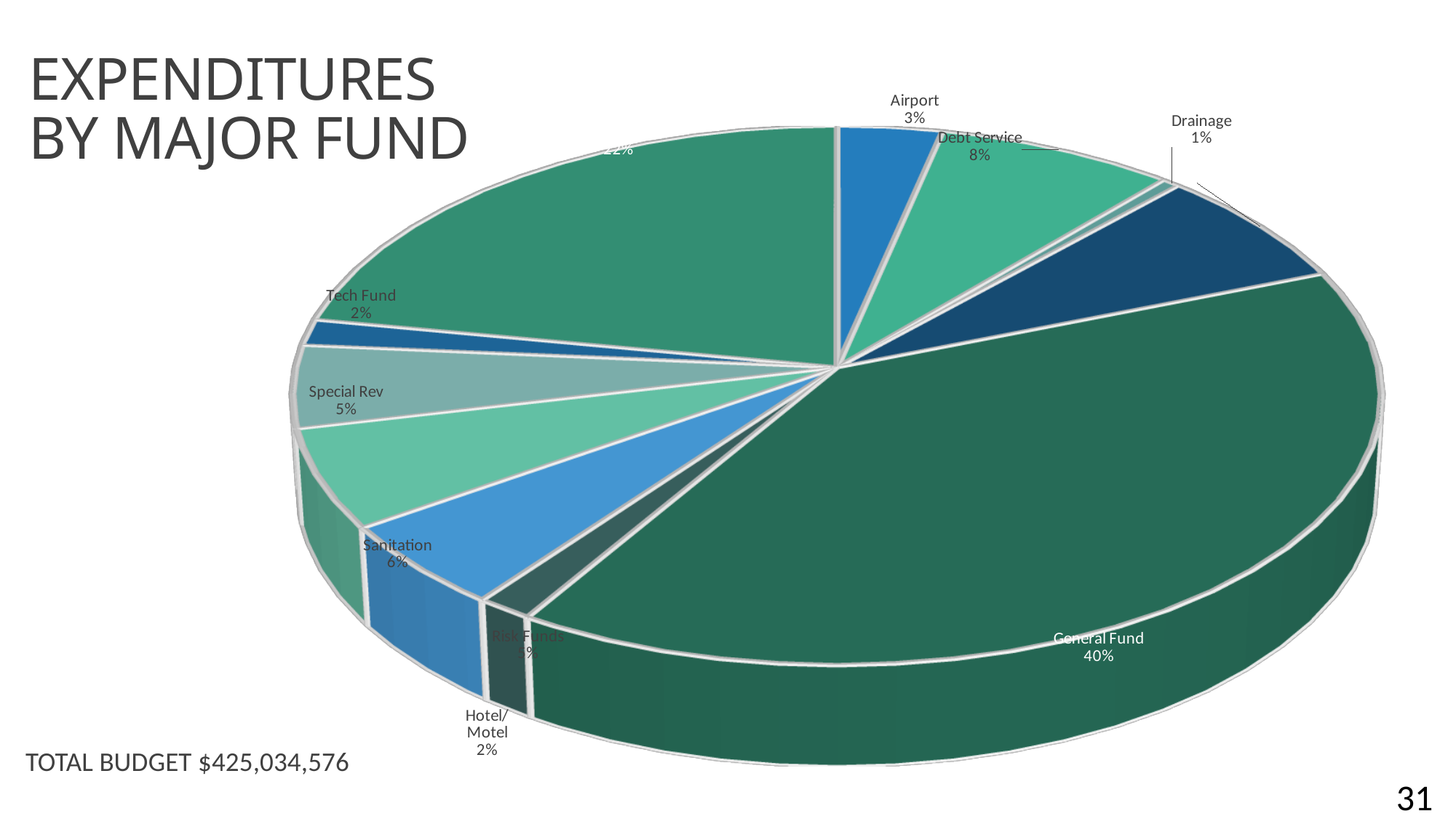
What percentage of expenditures is Debt Service? 8% Which fund has the largest share of expenditures? General Fund What percentage of expenditures is the Airport fund? 3% How many percentage points larger is the General Fund share than the Debt Service share? 32 percentage points What total budget is stated on the slide? $425,034,576 Which has a larger share of expenditures, Sanitation or Special Rev? Sanitation What percentage of expenditures is Sanitation? 6% What percentage of expenditures is the Tech Fund? 2% What kind of chart is shown on the slide? pie chart What share of expenditures does the General Fund represent? 40% What percentage of expenditures is Drainage? 1% What percentage of expenditures is Special Rev? 5%